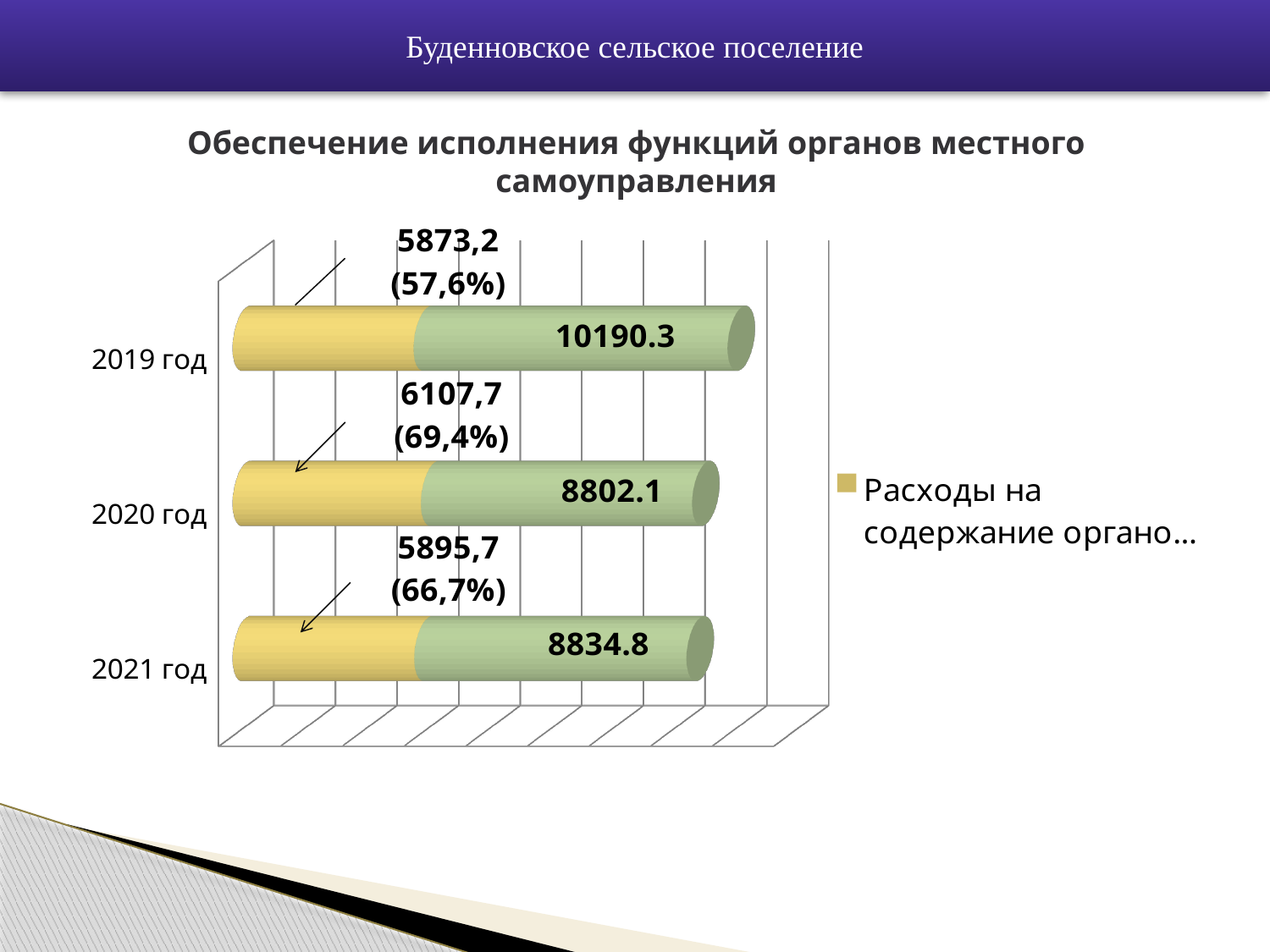
What kind of chart is shown on the slide? bar chart How many year categories are shown on the chart? 3 What is the difference between the green bar values for 2019 год and 2020 год? 1388.2 Which is larger, the yellow segment value for 2020 год or for 2019 год? 2020 год What value is printed on the green bar for 2020 год? 8802.1 Which year has the highest value on its green bar? 2019 год What percentage is shown for the yellow segment of 2021 год? 66,7% What value is printed on the green bar for 2019 год? 10190.3 Which year has the lowest value on its green bar? 2020 год How many series does the legend list? 1 What value and percentage are given for the yellow segment of 2020 год? 6107,7 (69,4%) What value is printed on the green bar for 2021 год? 8834.8